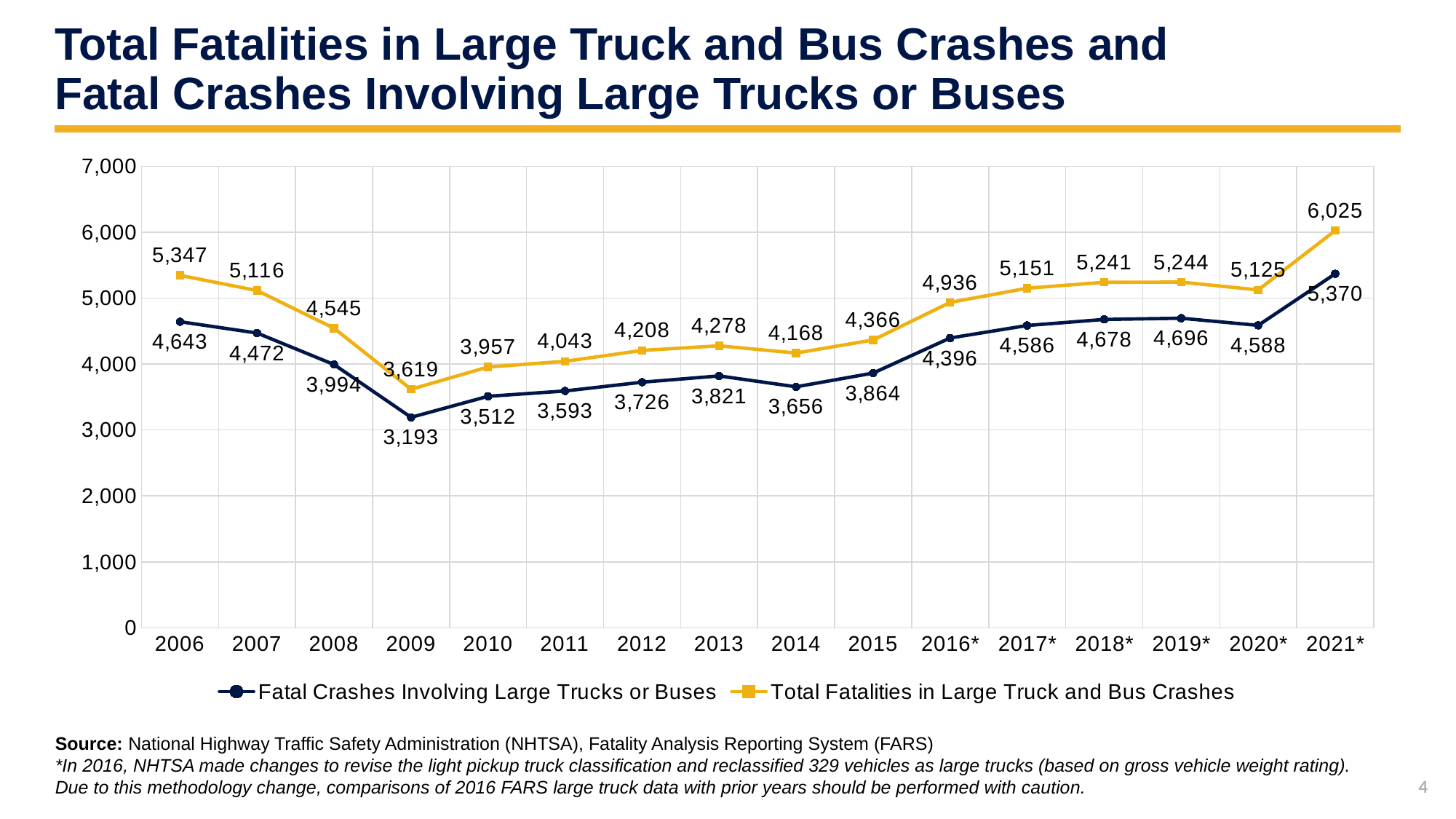
What was the value for Total Fatalities in Large Truck and Bus Crashes in 2009? 3,619 How many years are plotted along the x axis? 16 How many series does the legend list? 2 Did Total Fatalities in Large Truck and Bus Crashes rise or fall from 2006 to 2009? Fall What was the value for Fatal Crashes Involving Large Trucks or Buses in 2021*? 5,370 What type of chart is shown on the slide? Line chart In which year was Fatal Crashes Involving Large Trucks or Buses lowest? 2009 What colour is the line for Total Fatalities in Large Truck and Bus Crashes? Yellow/gold Which is larger: Fatal Crashes Involving Large Trucks or Buses in 2006 or in 2019*? 2019* What is the difference between Total Fatalities and Fatal Crashes in 2021*? 655 Is the value for Total Fatalities in Large Truck and Bus Crashes in 2021* greater or less than 6,000? greater In which year was Total Fatalities in Large Truck and Bus Crashes highest? 2021*